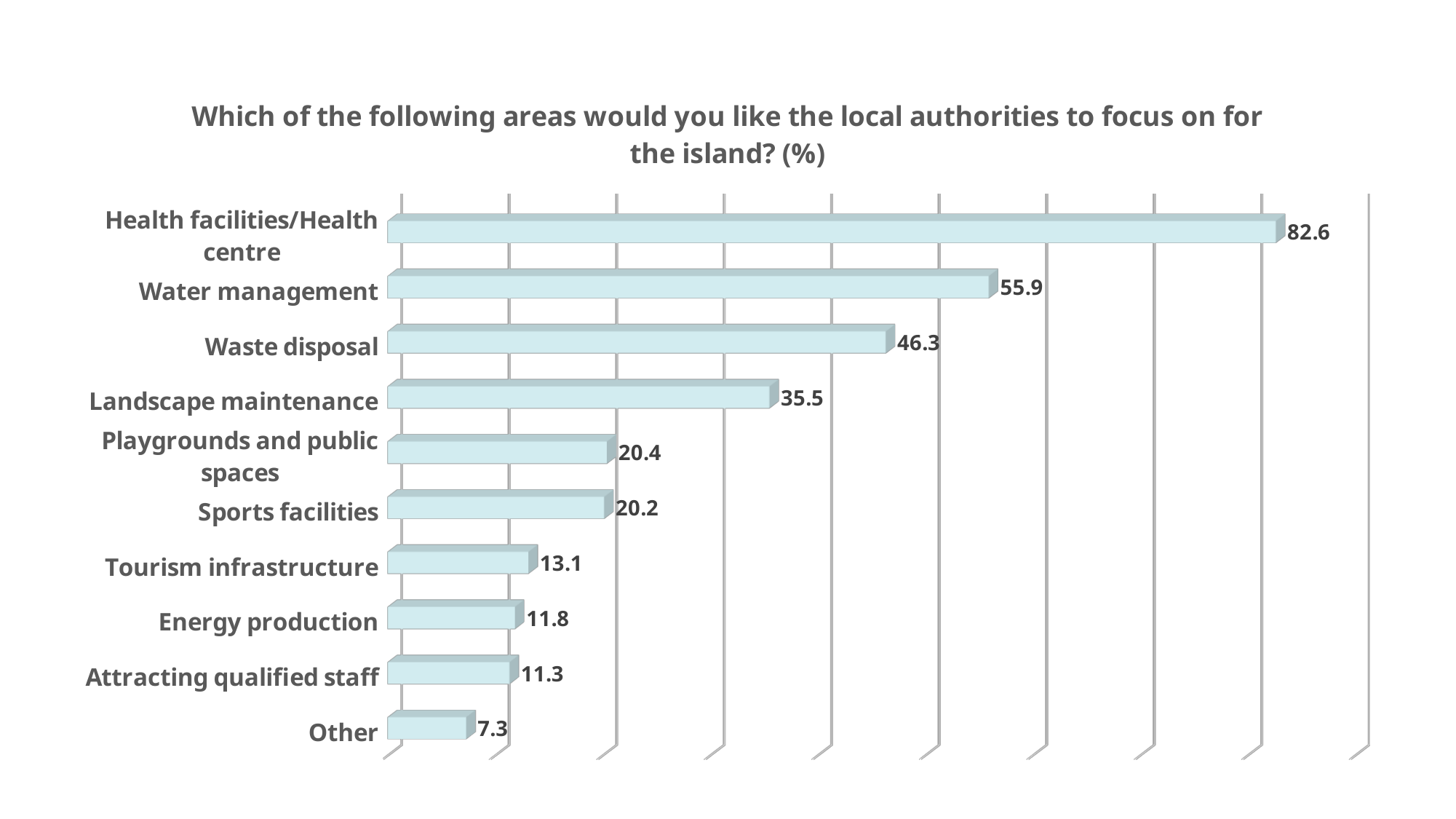
What is the value for Attracting qualified staff? 11.3 What is the difference between Health facilities/Health centre and Other? 75.3 What is the value for Waste disposal? 46.3 Which is larger, Energy production or Attracting qualified staff? Energy production Which is larger, Landscape maintenance or Tourism infrastructure? Landscape maintenance What is the value for Health facilities/Health centre? 82.6 What kind of chart is this? Bar chart Which area has the highest value? Health facilities/Health centre What is the title of the chart? Which of the following areas would you like the local authorities to focus on for the island? (%) What is the difference between Water management and Waste disposal? 9.6 How many areas are shown in the chart? 10 Which area has the lowest value? Other